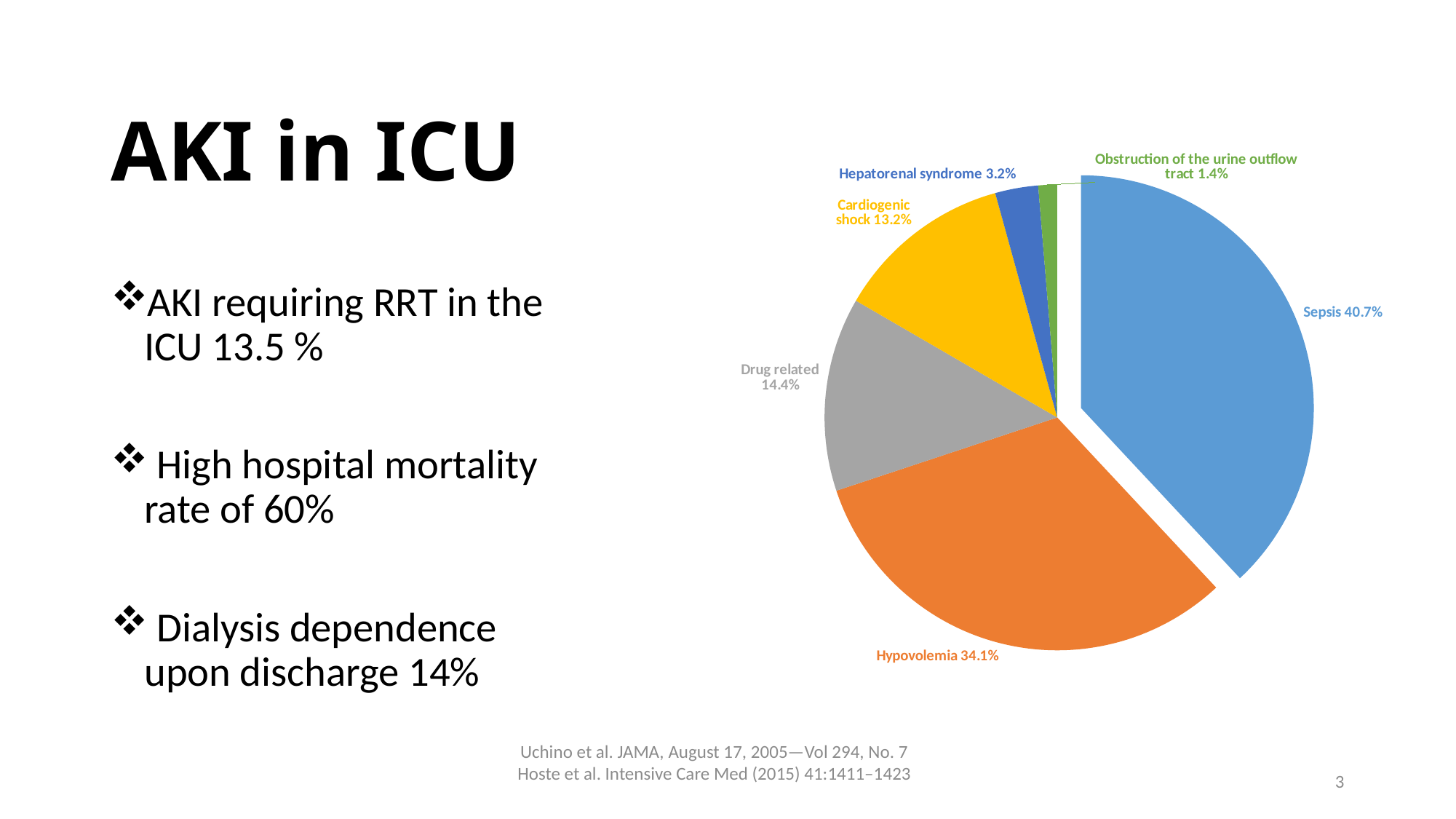
Which slice is pulled out (exploded) from the rest of the pie? Sepsis Which category has the smallest slice of the pie? Obstruction of the urine outflow tract Which is larger, Drug related or Cardiogenic shock? Drug related What is the difference between the Sepsis and Hypovolemia shares? 6.6% Which category has the largest slice of the pie? Sepsis What is the value shown for Drug related? 14.4% What is the value shown for Obstruction of the urine outflow tract? 1.4% How many categories are shown in the pie chart? 6 What is the value shown for Cardiogenic shock? 13.2% What is the value shown for Hypovolemia? 34.1% What kind of chart is shown on the slide? Pie chart What share of the pie does Sepsis account for? 40.7%